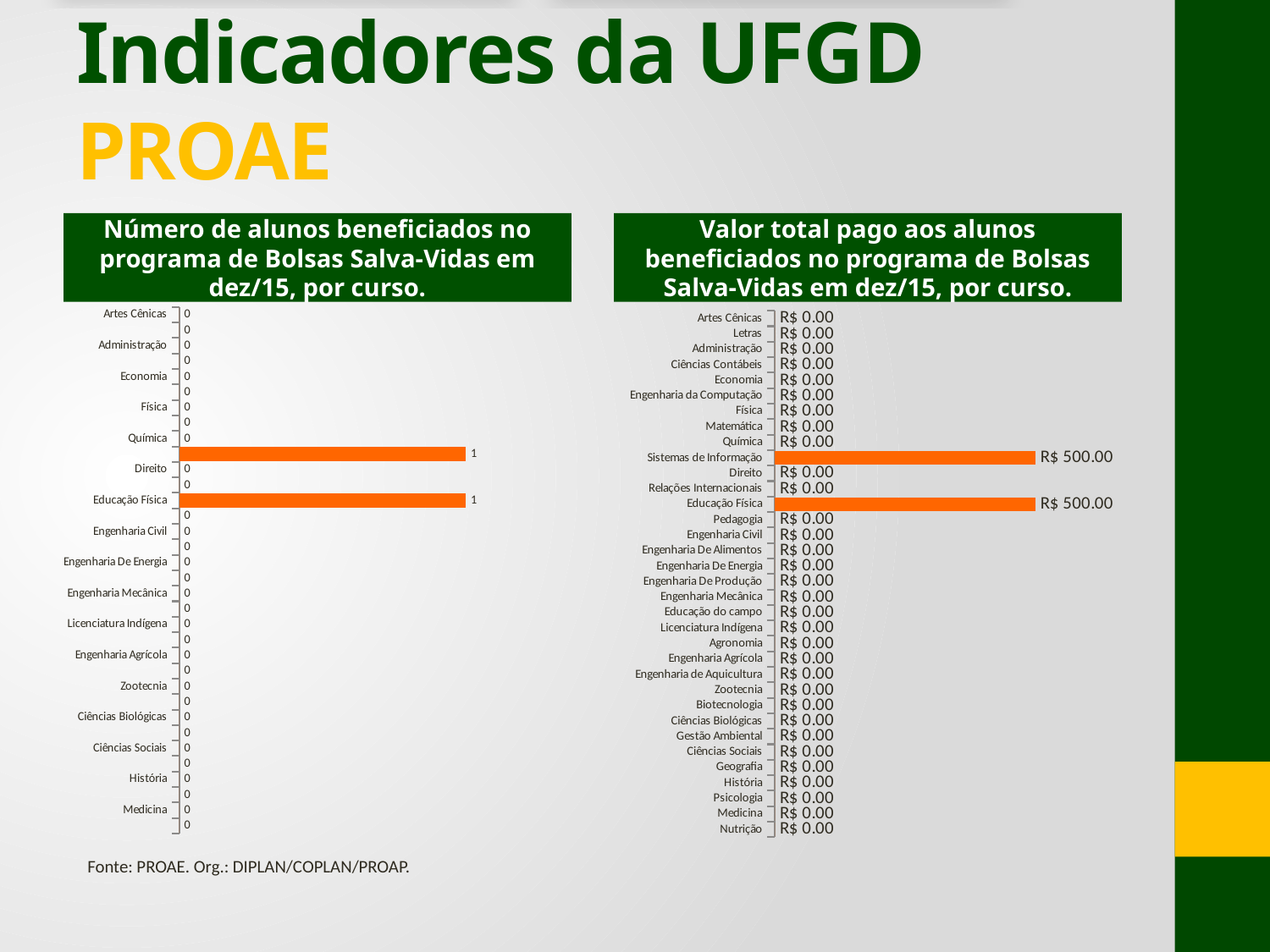
In the chart 'Valor total pago aos alunos beneficiados no programa de Bolsas Salva-Vidas em dez/15, por curso', what is the value for Sistemas de Informação? R$ 500.00 In the chart 'Valor total pago aos alunos beneficiados no programa de Bolsas Salva-Vidas em dez/15, por curso', what is the difference between the value for Educação Física and the value for Pedagogia? R$ 500.00 In the chart 'Número de alunos beneficiados no programa de Bolsas Salva-Vidas em dez/15, por curso', what is the value for Direito? 0 In the chart 'Valor total pago aos alunos beneficiados no programa de Bolsas Salva-Vidas em dez/15, por curso', how many courses are listed? 34 In the chart 'Número de alunos beneficiados no programa de Bolsas Salva-Vidas em dez/15, por curso', which is larger, the value for Educação Física or the value for Engenharia Civil? Educação Física In the chart 'Valor total pago aos alunos beneficiados no programa de Bolsas Salva-Vidas em dez/15, por curso', what is the value for Medicina? R$ 0.00 In the chart 'Valor total pago aos alunos beneficiados no programa de Bolsas Salva-Vidas em dez/15, por curso', what is the value for Educação Física? R$ 500.00 In the chart 'Valor total pago aos alunos beneficiados no programa de Bolsas Salva-Vidas em dez/15, por curso', which is larger, the value for Sistemas de Informação or the value for Direito? Sistemas de Informação What is the title of the chart on the left of the slide? Número de alunos beneficiados no programa de Bolsas Salva-Vidas em dez/15, por curso. What kind of chart is the chart on the right of the slide? Bar chart In the chart 'Valor total pago aos alunos beneficiados no programa de Bolsas Salva-Vidas em dez/15, por curso', how many courses have a value other than R$ 0.00? 2 In the chart 'Número de alunos beneficiados no programa de Bolsas Salva-Vidas em dez/15, por curso', what is the value for Educação Física? 1